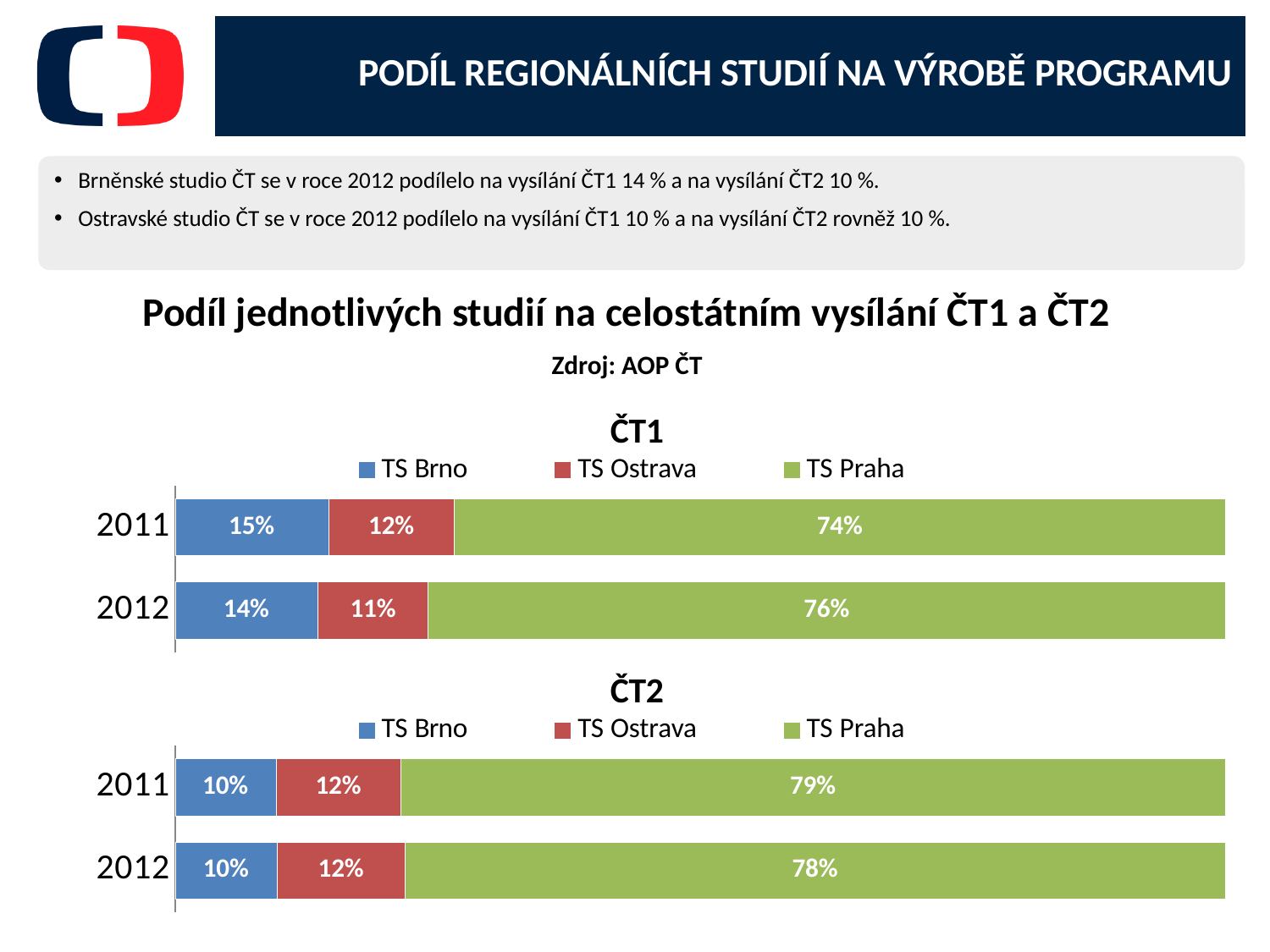
What kind of chart is the ČT1 chart? Stacked bar chart In the ČT1 chart, which studio has the largest share in 2012? TS Praha In the ČT2 chart, which is larger in 2011: TS Brno or TS Ostrava? TS Ostrava In the ČT2 chart, what is the value for TS Ostrava in 2012? 12% In the ČT2 chart, what is the value for TS Praha in 2011? 79% In the ČT1 chart, what is the value for TS Brno in 2011? 15% In the ČT1 chart, what is the value for TS Praha in 2012? 76% How many series does the legend of the ČT2 chart list? 3 How many years are shown in the ČT1 chart? 2 In the ČT1 chart, what is the difference between the TS Brno values for 2011 and 2012? 1% In the ČT1 chart, which studio has the smallest share in 2012? TS Ostrava In the ČT2 chart, what is the difference between the TS Praha values for 2011 and 2012? 1%